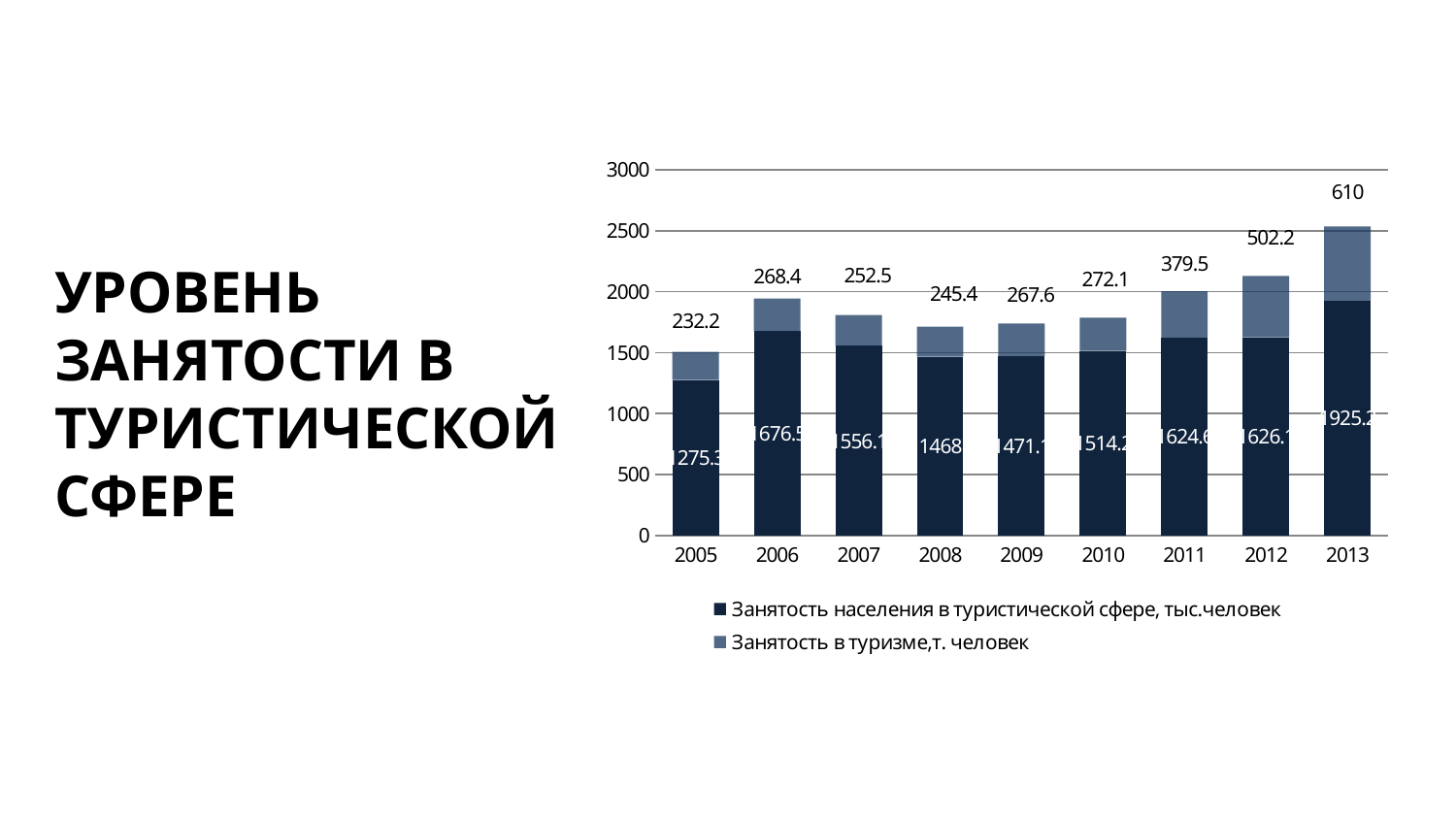
What is the difference between the 'Занятость в туризме,т. человек' values for 2013 and 2012? 107.8 What is the value of 'Занятость населения в туристической сфере, тыс.человек' for 2008? 1468 What kind of chart is shown on the slide? bar chart What is the value of 'Занятость в туризме,т. человек' for 2005? 232.2 Is the total height of the stacked bar for 2013 greater or less than 2500? greater What is the value of 'Занятость в туризме,т. человек' for 2013? 610 In which year is 'Занятость в туризме,т. человек' highest? 2013 Does 'Занятость в туризме,т. человек' rise or fall from 2010 to 2013? rise How many years are shown on the x axis of the chart? 9 How many series does the chart legend list? 2 Which year has the larger 'Занятость в туризме,т. человек' value, 2010 or 2011? 2011 In which year is 'Занятость в туризме,т. человек' lowest? 2005